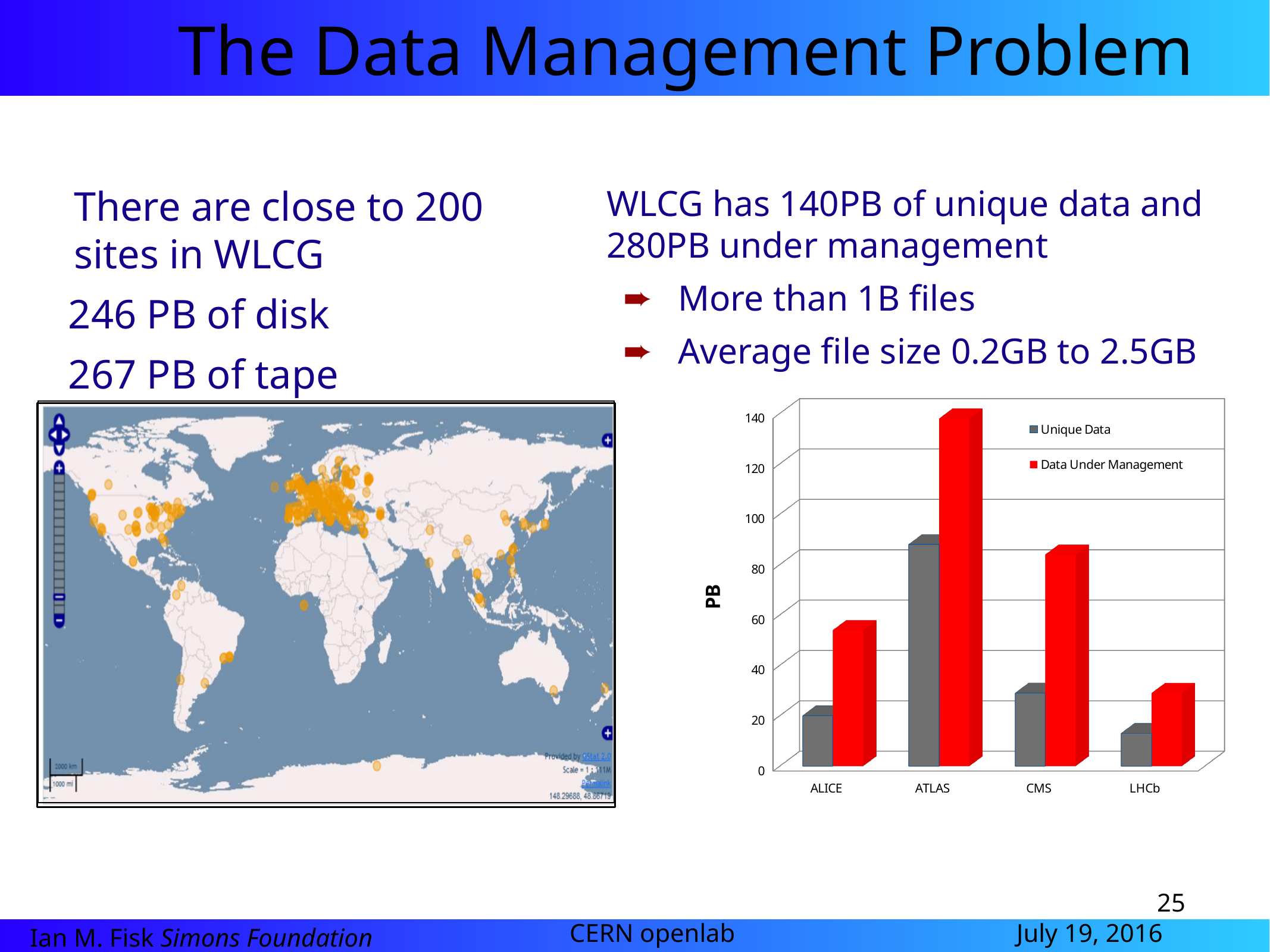
How many categories are shown on the x axis of the chart? 4 Which colour represents the Data Under Management series in the chart? red Is the Data Under Management value for CMS greater or less than 60? greater How many series does the chart legend list? 2 Is the Unique Data value for ALICE greater or less than 40? less Which category has the highest Data Under Management value? ATLAS Which category has the highest Unique Data value? ATLAS What is the label on the vertical axis of the chart? PB What kind of chart is shown on the slide? bar chart Which is larger, the Data Under Management value for ALICE or for LHCb? ALICE Which category has the lowest Unique Data value? LHCb Is the Data Under Management value for ATLAS greater or less than 120? greater